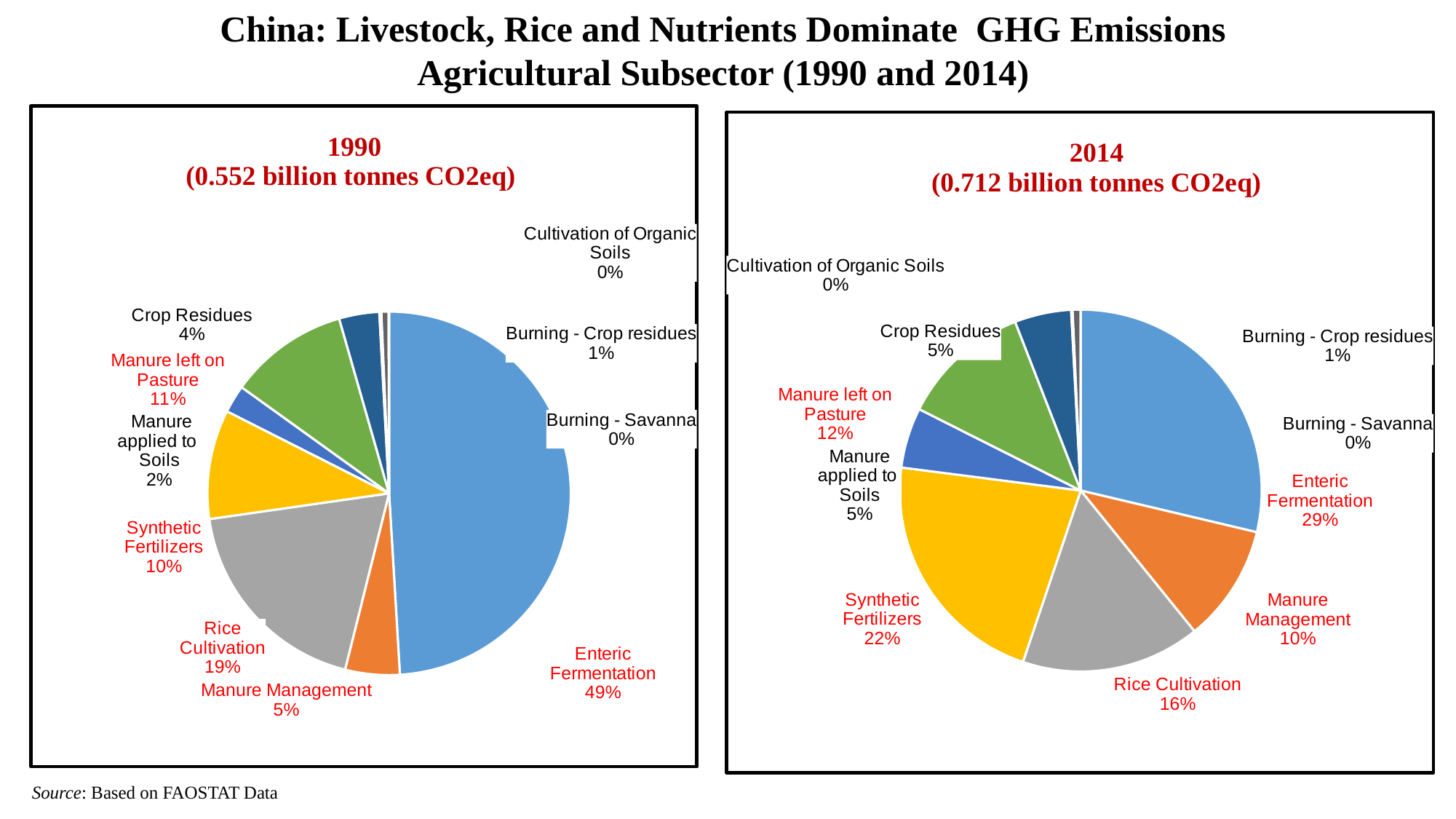
In the 2014 pie chart, what is the share for Crop Residues? 5% In the 1990 pie chart, what share of emissions comes from Enteric Fermentation? 49% What type of chart is used on this slide? Pie chart In the 2014 pie chart, what is the share for Rice Cultivation? 16% How many categories are shown in the 1990 pie chart? 10 In the 1990 pie chart, what is the difference in percentage points between Rice Cultivation and Synthetic Fertilizers? 9 In the 1990 pie chart, what is the share for Manure left on Pasture? 11% In the 2014 pie chart, which is larger: Manure left on Pasture or Manure Management? Manure left on Pasture In the 2014 pie chart, which category has the largest share? Enteric Fermentation What total emissions figure is given in the title of the 2014 chart? 0.712 billion tonnes CO2eq In the 2014 pie chart, what share of emissions comes from Synthetic Fertilizers? 22% In the 1990 pie chart, which category has the largest share? Enteric Fermentation